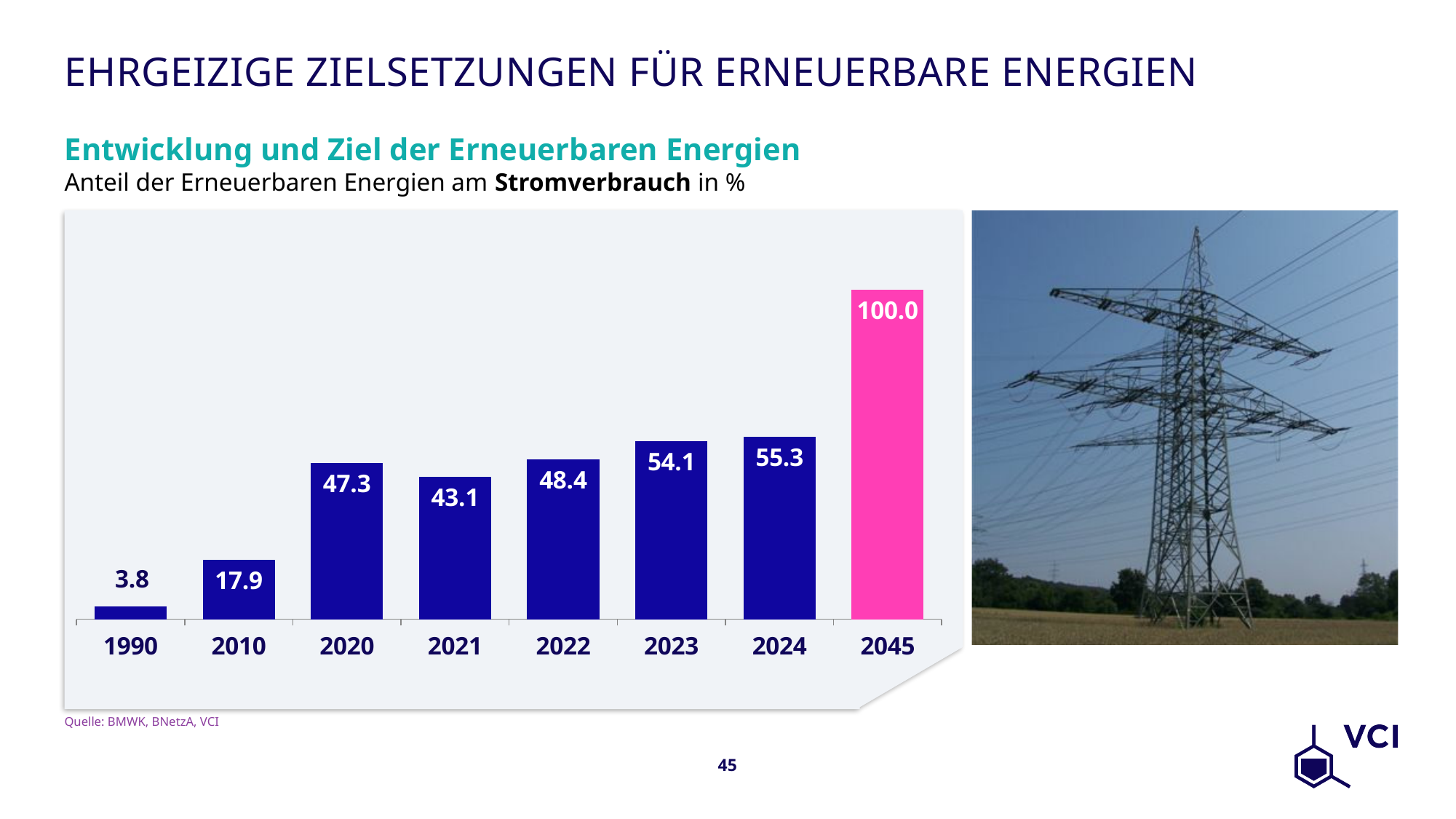
What kind of chart is shown on the slide? Bar chart What is the difference between the values for 2020 and 2021? 4.2 Which is larger, the value for 2020 or the value for 2021? 2020 What value is shown for 2024? 55.3 What value is shown for 1990? 3.8 What value is shown for the 2045 target? 100.0 Which bar in the chart is coloured pink instead of dark blue? 2045 How many years are shown on the x axis of the chart? 8 Which year has the highest value in the chart? 2045 What is the difference between the values for 2024 and 2023? 1.2 What is the share of renewable energies in electricity consumption shown for 2020? 47.3 Which year has the lowest value in the chart? 1990